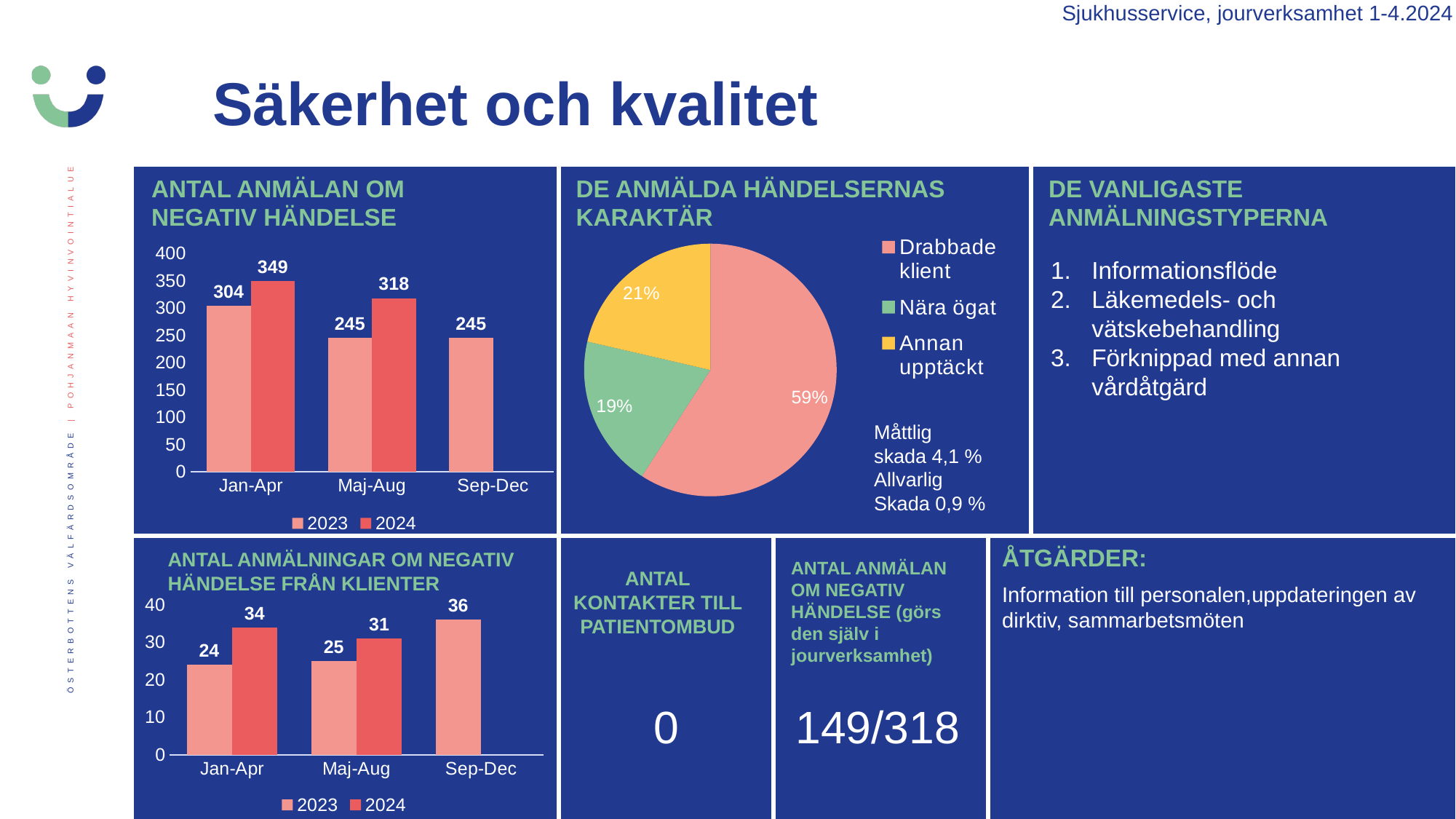
In the pie chart 'DE ANMÄLDA HÄNDELSERNAS KARAKTÄR', which category has the smallest slice? Nära ögat In the chart 'ANTAL ANMÄLAN OM NEGATIV HÄNDELSE', what is the difference between the 2024 and 2023 values for Jan-Apr? 45 What kind of chart is 'DE ANMÄLDA HÄNDELSERNAS KARAKTÄR'? Pie chart In the chart 'ANTAL ANMÄLAN OM NEGATIV HÄNDELSE', what is the value for 2024 in Jan-Apr? 349 In the chart 'ANTAL ANMÄLAN OM NEGATIV HÄNDELSE', which period has the highest 2024 value? Jan-Apr In the chart 'ANTAL ANMÄLNINGAR OM NEGATIV HÄNDELSE FRÅN KLIENTER', what is the value for 2023 in Sep-Dec? 36 In the pie chart 'DE ANMÄLDA HÄNDELSERNAS KARAKTÄR', what share does 'Drabbade klient' have? 59% In the chart 'ANTAL ANMÄLAN OM NEGATIV HÄNDELSE', what is the value for 2023 in Maj-Aug? 245 In the pie chart 'DE ANMÄLDA HÄNDELSERNAS KARAKTÄR', what share does 'Nära ögat' have? 19% In the chart 'ANTAL ANMÄLAN OM NEGATIV HÄNDELSE', how many series does the legend list? 2 In the chart 'ANTAL ANMÄLNINGAR OM NEGATIV HÄNDELSE FRÅN KLIENTER', which is larger in Maj-Aug, 2023 or 2024? 2024 In the chart 'ANTAL ANMÄLNINGAR OM NEGATIV HÄNDELSE FRÅN KLIENTER', how many periods are shown on the x axis? 3